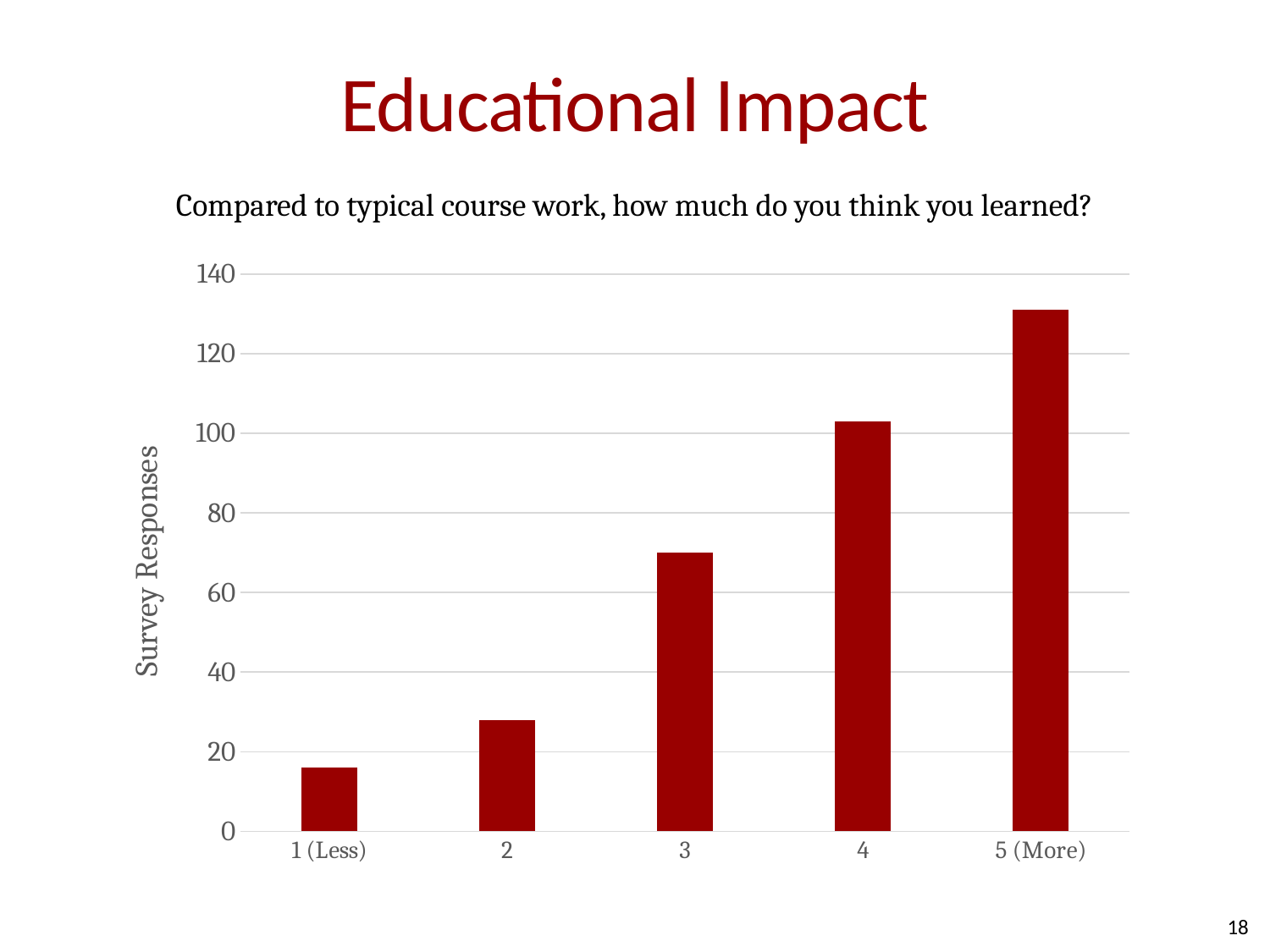
What kind of chart is shown on the slide? bar chart What is the label on the y axis of the chart? Survey Responses Is the value for 5 (More) greater or less than 120? greater Do the survey responses rise or fall from 1 (Less) to 5 (More)? rise Is the value for 1 (Less) greater or less than 20? less Is the value for 4 greater or less than 100? greater What question is the chart titled with? Compared to typical course work, how much do you think you learned? Which has more survey responses, category 2 or category 4? 4 Which category has the lowest number of survey responses? 1 (Less) How many categories are shown on the x axis? 5 Which category has the highest number of survey responses? 5 (More)